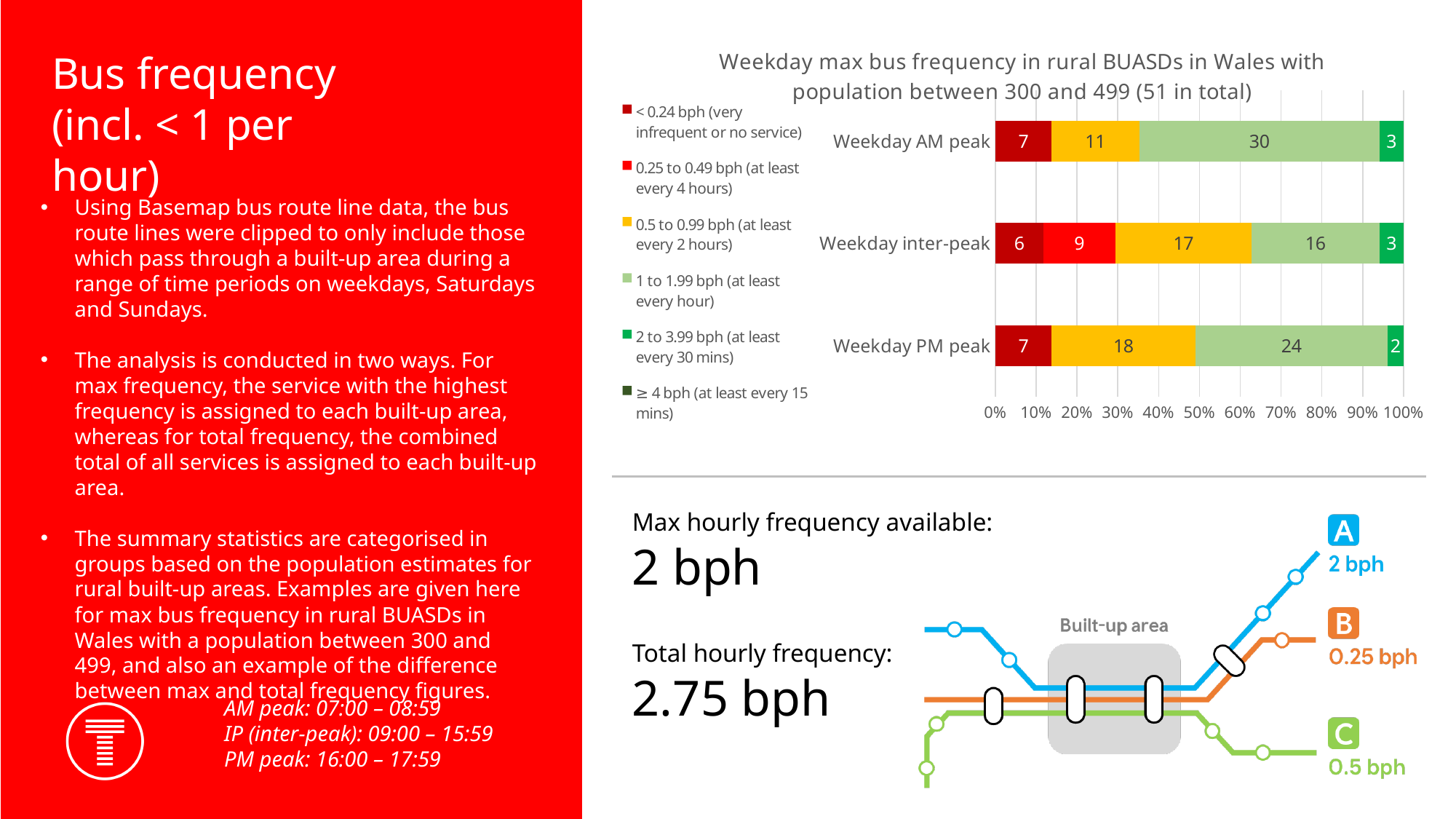
How many rural BUASDs have a max frequency of 0.25 to 0.49 bph in the Weekday inter-peak? 9 How many rural BUASDs have a max frequency of 2 to 3.99 bph in the Weekday PM peak? 2 How many series does the chart legend list? 6 How many time-period categories are plotted on the chart? 3 What is the total number of BUASDs across all segments of the Weekday inter-peak bar? 51 What kind of chart is shown on the slide? Stacked bar chart How many rural BUASDs have a max frequency of 0.5 to 0.99 bph in the Weekday PM peak? 18 What is the difference between the 0.5 to 0.99 bph counts for the Weekday PM peak and the Weekday AM peak? 7 How many rural BUASDs have a max frequency of 1 to 1.99 bph in the Weekday AM peak? 30 Which time period has the lowest number of BUASDs in the 1 to 1.99 bph category? Weekday inter-peak Which time period has the highest number of BUASDs in the 1 to 1.99 bph category? Weekday AM peak Is the number of BUASDs with < 0.24 bph larger in the Weekday AM peak or the Weekday inter-peak? Weekday AM peak